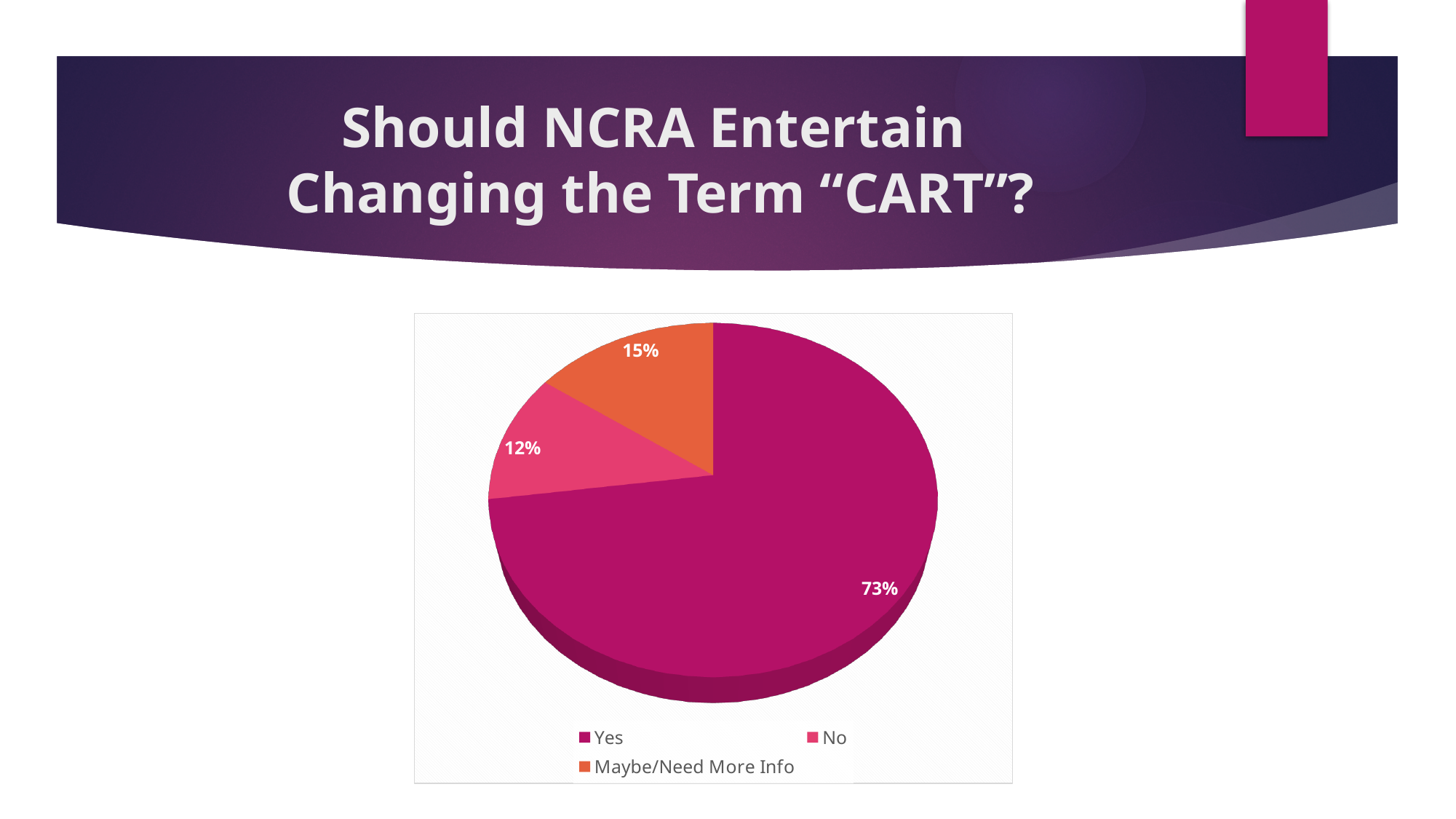
Which slice is larger, "No" or "Maybe/Need More Info"? Maybe/Need More Info What kind of chart is shown on the slide? pie chart What is the difference in percentage points between the "Yes" and "No" slices? 61 What percentage of respondents answered "Maybe/Need More Info"? 15% Which response has the largest share of the pie? Yes What percentage of respondents answered "Yes"? 73% What is the difference in percentage points between the "Maybe/Need More Info" and "No" slices? 3 What percentage of respondents answered "No"? 12% What colour is the "Maybe/Need More Info" slice? orange Which response has the smallest share of the pie? No How many entries does the legend list? 3 How many slices does the pie chart have? 3